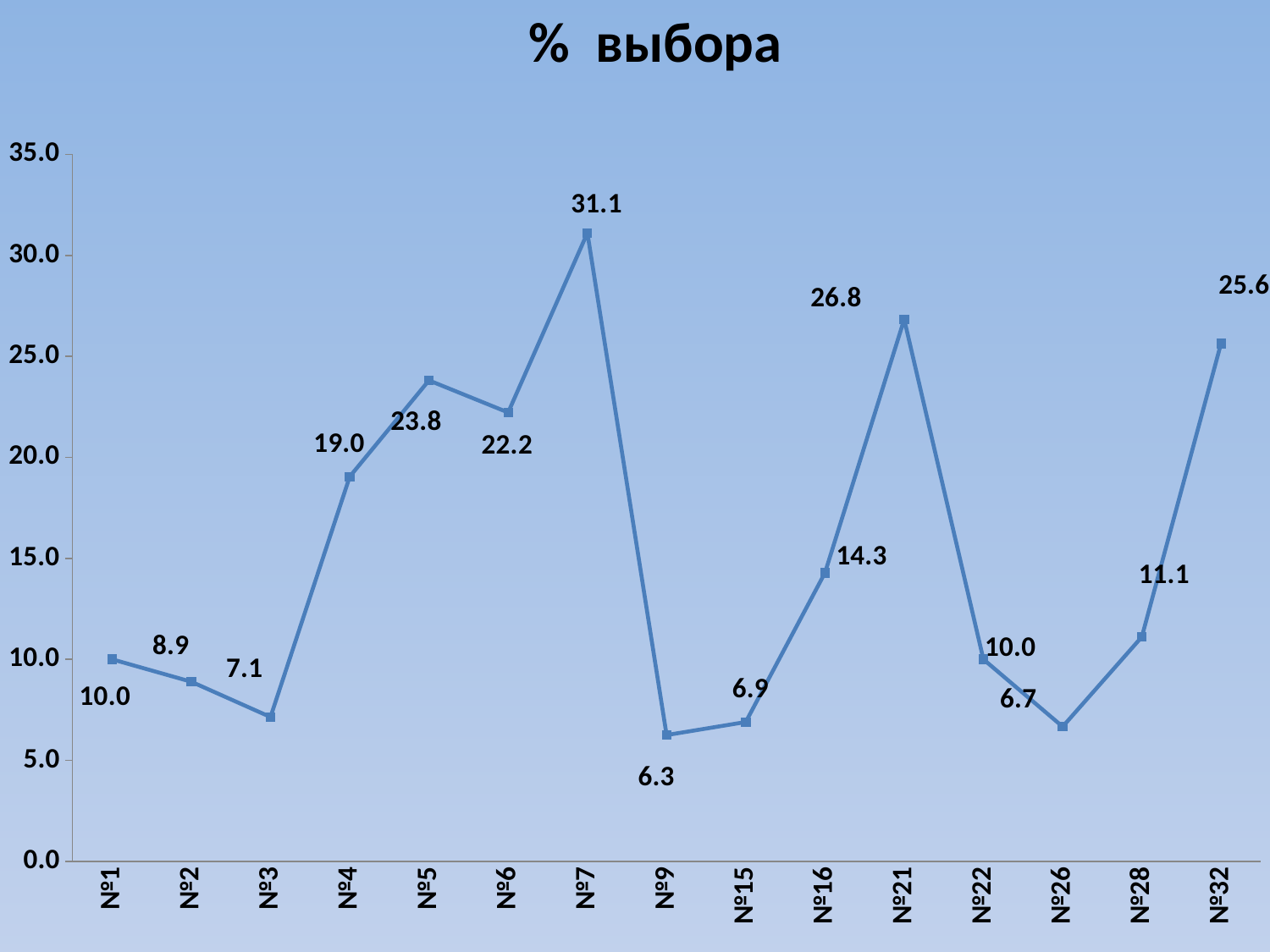
What is the value for №7? 31.1 How many categories are plotted on the x axis? 15 What is the title of the chart? % выбора Which category has the highest value? №7 Which category has the lowest value? №9 Is the value for №16 greater or less than 15.0? less What is the value for №9? 6.3 What is the value for №32? 25.6 What kind of chart is shown? line chart What is the difference between the values for №7 and №21? 4.3 What is the value for №21? 26.8 Which is larger, the value for №5 or the value for №6? №5